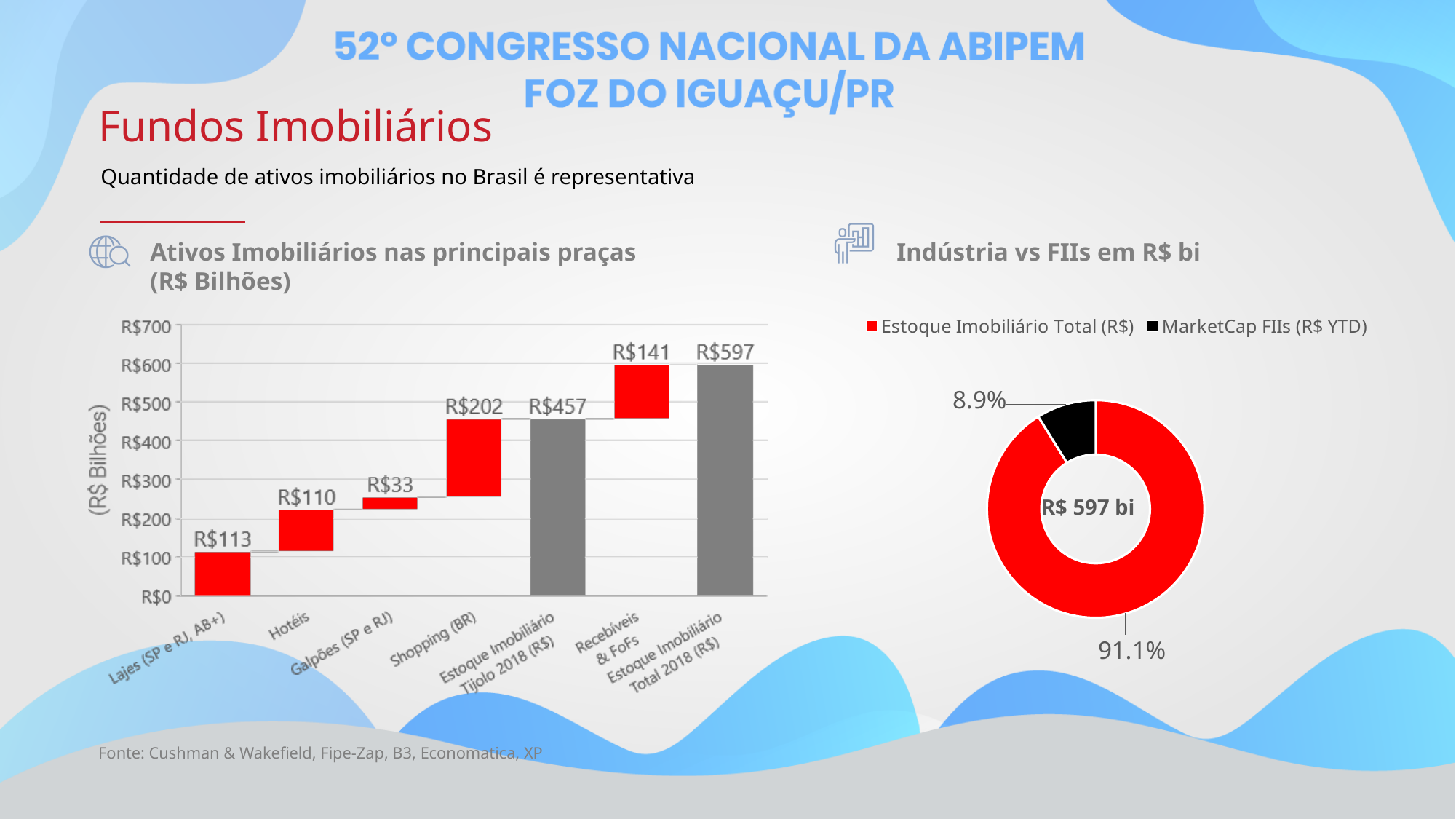
How many categories are shown on the x axis of the chart 'Ativos Imobiliários nas principais praças (R$ Bilhões)'? 7 In the chart 'Indústria vs FIIs em R$ bi', what share does MarketCap FIIs (R$ YTD) represent? 8.9% In the chart 'Ativos Imobiliários nas principais praças (R$ Bilhões)', what is the value for Estoque Imobiliário Tijolo 2018 (R$)? R$457 In the chart 'Ativos Imobiliários nas principais praças (R$ Bilhões)', what is the difference between Estoque Imobiliário Total 2018 (R$) and Estoque Imobiliário Tijolo 2018 (R$)? R$140 What kind of chart is 'Ativos Imobiliários nas principais praças (R$ Bilhões)'? Bar chart In the chart 'Ativos Imobiliários nas principais praças (R$ Bilhões)', which category has the lowest value? Galpões (SP e RJ) In the chart 'Ativos Imobiliários nas principais praças (R$ Bilhões)', what is the value for Shopping (BR)? R$202 How many series does the legend of the chart 'Indústria vs FIIs em R$ bi' list? 2 In the chart 'Ativos Imobiliários nas principais praças (R$ Bilhões)', what is the value for Galpões (SP e RJ)? R$33 What value is printed in the centre of the donut chart 'Indústria vs FIIs em R$ bi'? R$ 597 bi In the chart 'Ativos Imobiliários nas principais praças (R$ Bilhões)', which category has the highest value? Estoque Imobiliário Total 2018 (R$) In the chart 'Ativos Imobiliários nas principais praças (R$ Bilhões)', which is larger: Shopping (BR) or Recebíveis & FoFs? Shopping (BR)